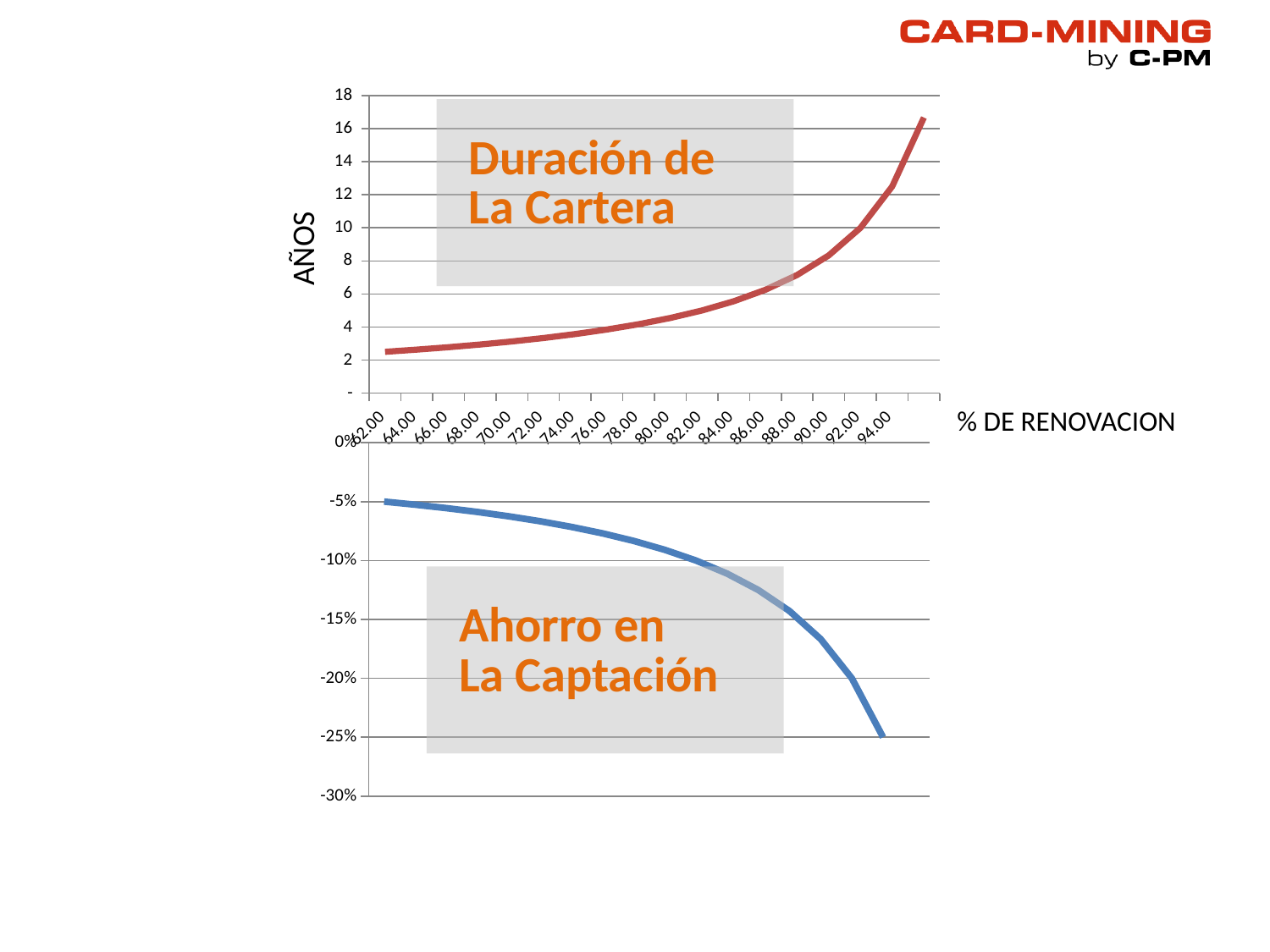
What is the label on the vertical axis of the top chart 'Duración de La Cartera'? AÑOS In the top chart 'Duración de La Cartera', which x-axis category has the lowest value? 62.00 What colour is the line in the bottom chart 'Ahorro en La Captación'? blue What kind of chart is the top chart titled 'Duración de La Cartera'? line chart In the bottom chart 'Ahorro en La Captación', is the value at 70.00 greater or less than -10%? greater In the top chart 'Duración de La Cartera', is the value at 92.00 greater or less than 8? greater In the top chart 'Duración de La Cartera', is the value at 70.00 greater or less than 4? less In the top chart 'Duración de La Cartera', do the values rise or fall as % de renovación increases along the x axis? rise What kind of chart is the bottom chart titled 'Ahorro en La Captación'? line chart In the bottom chart 'Ahorro en La Captación', do the values rise or fall as % de renovación increases along the x axis? fall